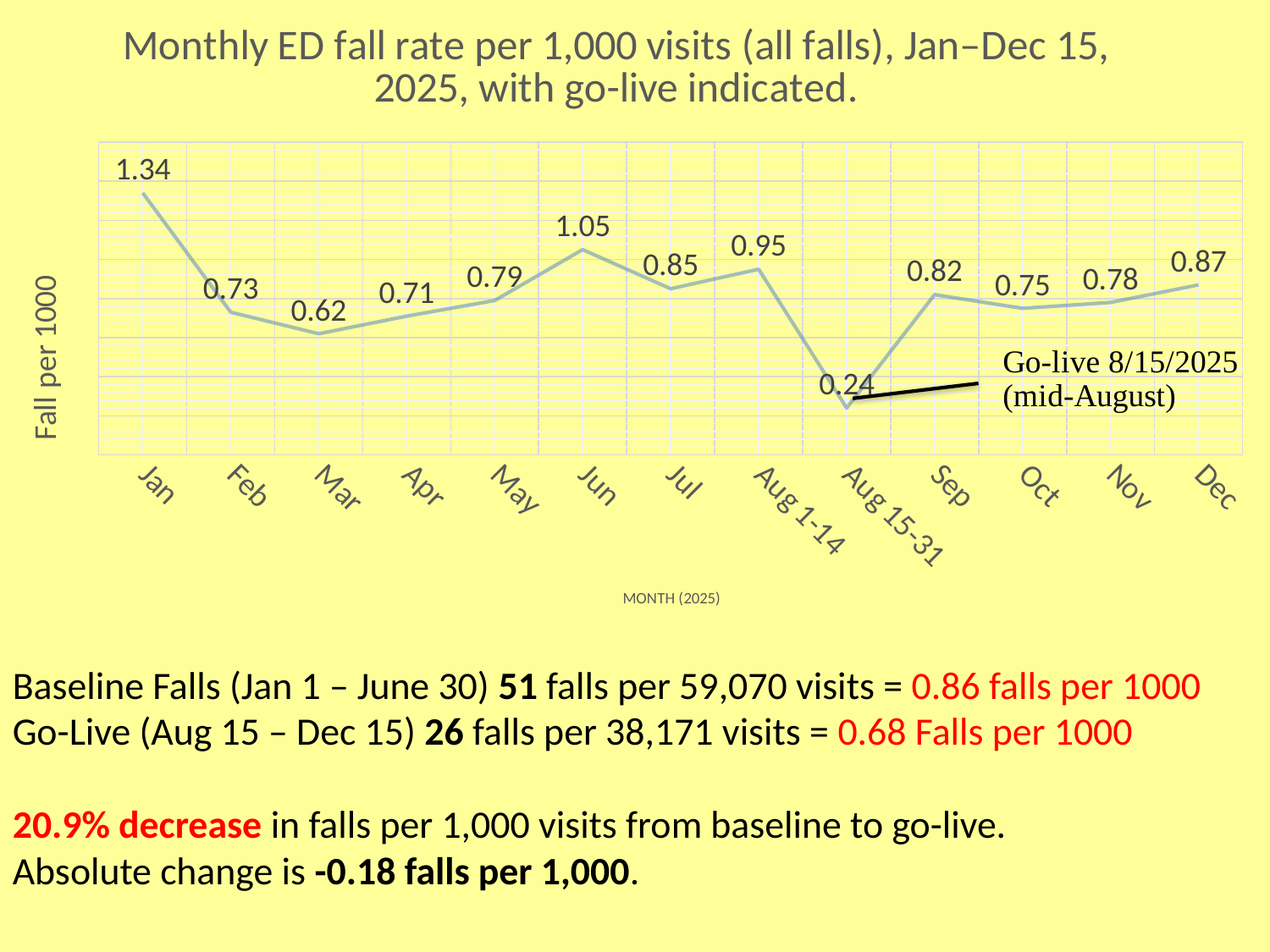
What is the difference between the fall rate for Jan and the fall rate for Feb? 0.61 How many data points are plotted on the chart? 13 What is the fall rate per 1,000 visits for Dec? 0.87 Which period has the lowest fall rate per 1,000 visits? Aug 15-31 Which has a higher fall rate per 1,000 visits, Sep or Oct? Sep What is the fall rate per 1,000 visits for Aug 15-31? 0.24 What is the difference between the fall rate for Aug 1-14 and the fall rate for Aug 15-31? 0.71 What kind of chart is shown on the slide? Line chart What is the fall rate per 1,000 visits for Jan? 1.34 Which month has the highest fall rate per 1,000 visits? Jan What is the fall rate per 1,000 visits for Jun? 1.05